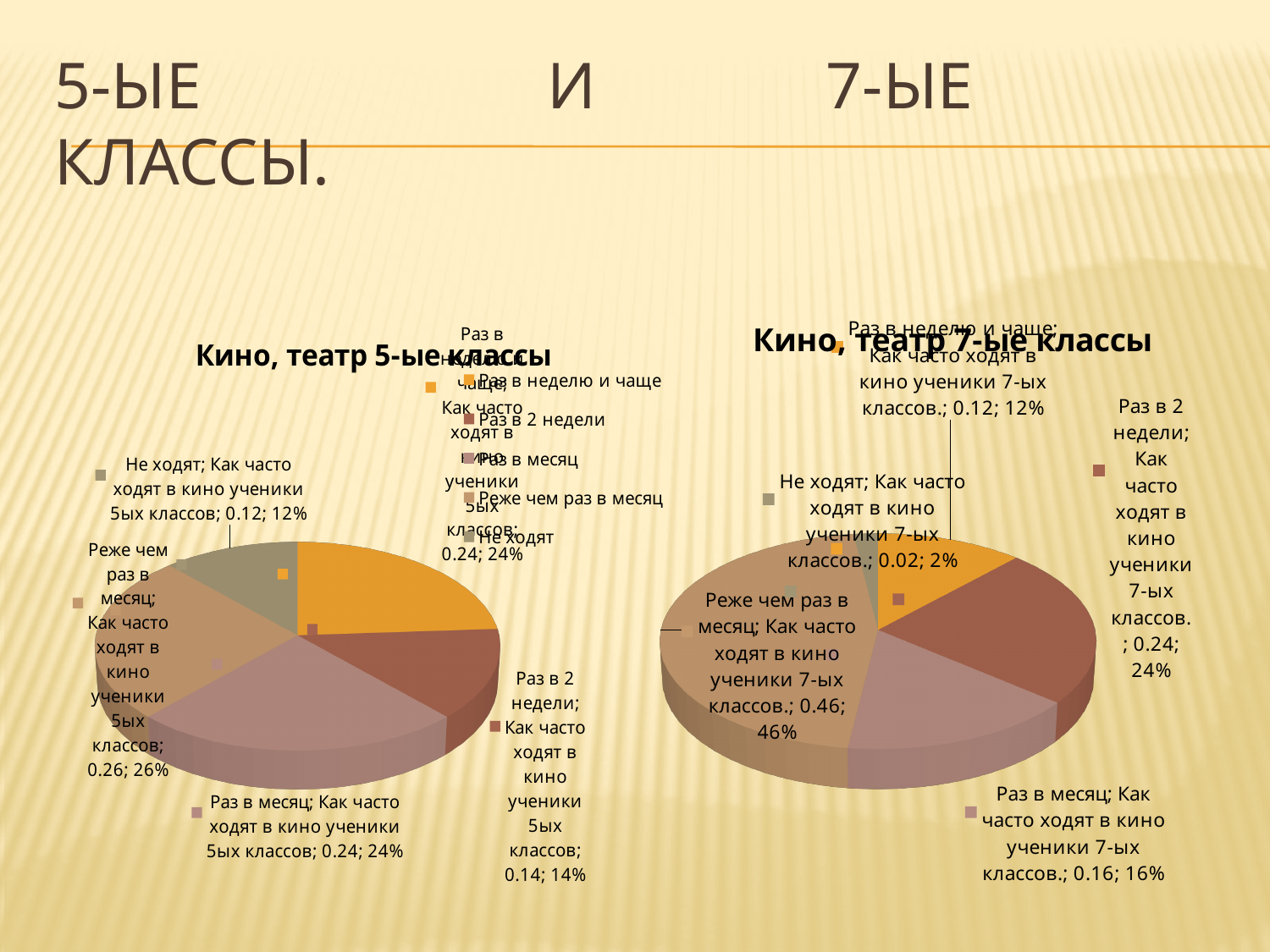
In the chart 'Кино, театр 7-ые классы', which category has the largest share? Реже чем раз в месяц In the chart 'Кино, театр 5-ые классы', what share is labelled for 'Реже чем раз в месяц'? 26% In the chart 'Кино, театр 5-ые классы', which category has the smallest share? Не ходят In the chart 'Кино, театр 7-ые классы', what share is labelled for 'Реже чем раз в месяц'? 46% In the chart 'Кино, театр 7-ые классы', what is the difference in percentage points between 'Раз в 2 недели' and 'Раз в месяц'? 8 In the chart 'Кино, театр 7-ые классы', what share is labelled for 'Не ходят'? 2% How many entries does the legend of the chart 'Кино, театр 5-ые классы' list? 5 In the chart 'Кино, театр 5-ые классы', which category has the largest share? Реже чем раз в месяц In the chart 'Кино, театр 7-ые классы', which is larger: the share for 'Раз в неделю и чаще' or for 'Раз в 2 недели'? Раз в 2 недели What kind of chart is 'Кино, театр 5-ые классы'? Pie chart In the chart 'Кино, театр 5-ые классы', how many slices does the pie have? 5 In the chart 'Кино, театр 5-ые классы', what share is labelled for 'Не ходят'? 12%